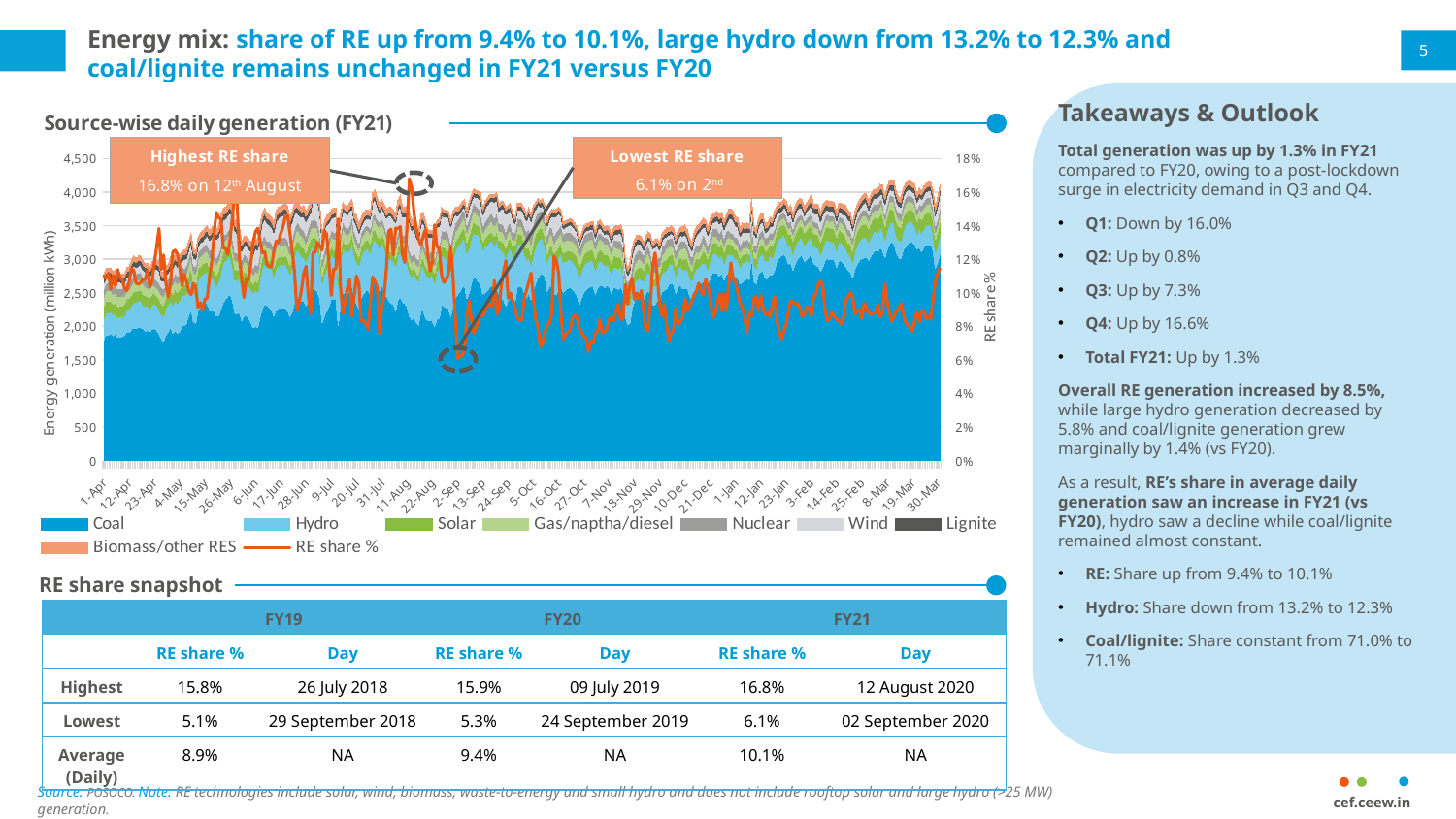
What is the label of the left-hand vertical axis of the chart? Energy generation (million kWh) Is the lowest RE share annotated on the chart greater or less than 8%? less What is the label of the right-hand vertical axis of the chart? RE share % According to the annotation on the chart, what was the highest RE share in FY21? 16.8% What kind of chart is 'Source-wise daily generation (FY21)'? Stacked area chart with a line for RE share % Is the highest RE share annotated on the chart greater or less than 16%? greater According to the annotation on the chart, what was the lowest RE share in FY21? 6.1% How many series does the legend of the 'Source-wise daily generation (FY21)' chart list? 9 On which date did the highest RE share of 16.8% occur, according to the chart annotation? 12th August Is the total daily generation on 1-Apr greater or less than 3,500 million kWh? less Which source contributes the largest area in the 'Source-wise daily generation (FY21)' chart? Coal What is the difference between the highest RE share (16.8%) and the lowest RE share (6.1%) shown on the chart? 10.7 percentage points